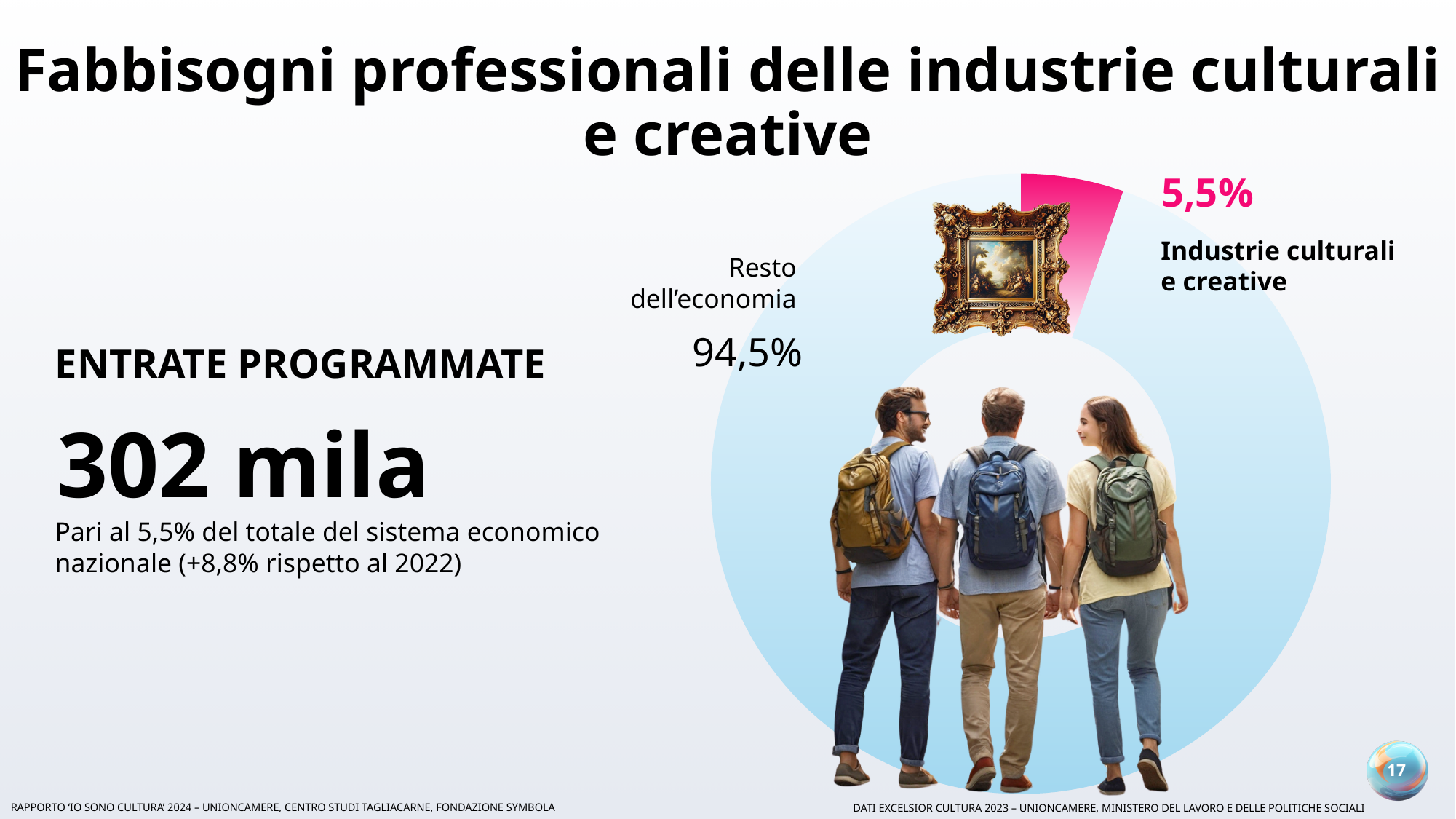
Which slice of the pie chart is the largest? Resto dell'economia How many slices does the pie chart have? 2 Which slice of the pie chart is the smallest? Industrie culturali e creative What share of the pie chart is labelled "Resto dell'economia"? 94,5% Is the share for "Industrie culturali e creative" greater or less than 10%? less What is the difference in percentage points between the "Resto dell'economia" slice and the "Industrie culturali e creative" slice? 89 percentage points What colour is the "Industrie culturali e creative" slice in the pie chart? Pink Which is larger in the pie chart: "Resto dell'economia" or "Industrie culturali e creative"? Resto dell'economia What is the total of the two slices shown in the pie chart? 100% What kind of chart is shown on the slide? Doughnut chart What share of the pie chart is labelled "Industrie culturali e creative"? 5,5%